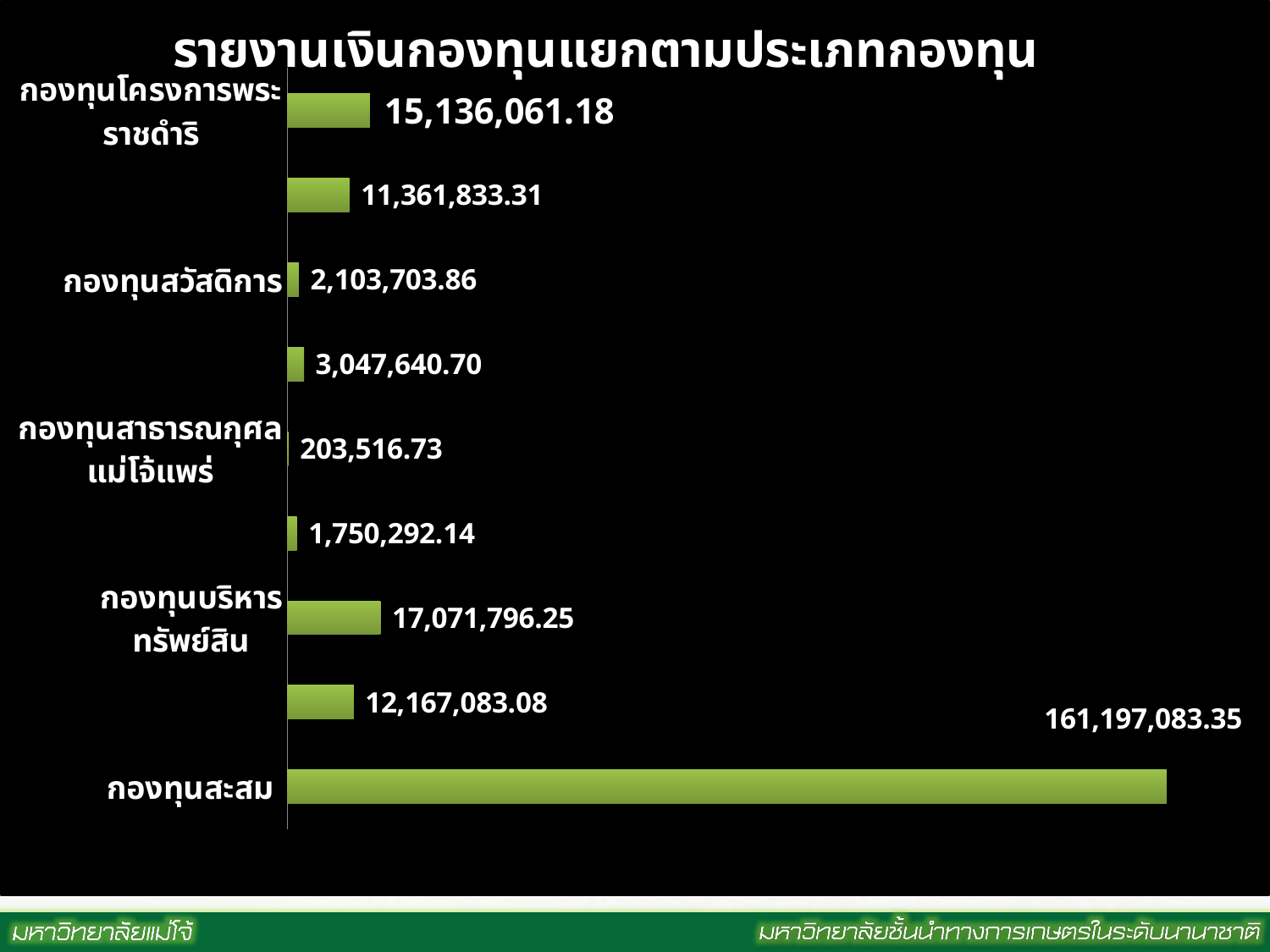
Which fund has the lowest value? กองทุนสาธารณกุศลแม่โจ้แพร่ What is the value for กองทุนสาธารณกุศลแม่โจ้แพร่? 203,516.73 What is the difference between the values for กองทุนบริหารทรัพย์สิน and กองทุนโครงการพระราชดำริ? 1,935,735.07 What is the value for กองทุนโครงการพระราชดำริ? 15,136,061.18 What is the title of the chart? รายงานเงินกองทุนแยกตามประเภทกองทุน What is the value for กองทุนสวัสดิการ? 2,103,703.86 What is the value for กองทุนสะสม? 161,197,083.35 What is the value for กองทุนบริหารทรัพย์สิน? 17,071,796.25 Which is larger, the value for กองทุนบริหารทรัพย์สิน or กองทุนโครงการพระราชดำริ? กองทุนบริหารทรัพย์สิน What type of chart is shown on the slide? Bar chart Which fund has the highest value? กองทุนสะสม How many bars are plotted in the chart? 9